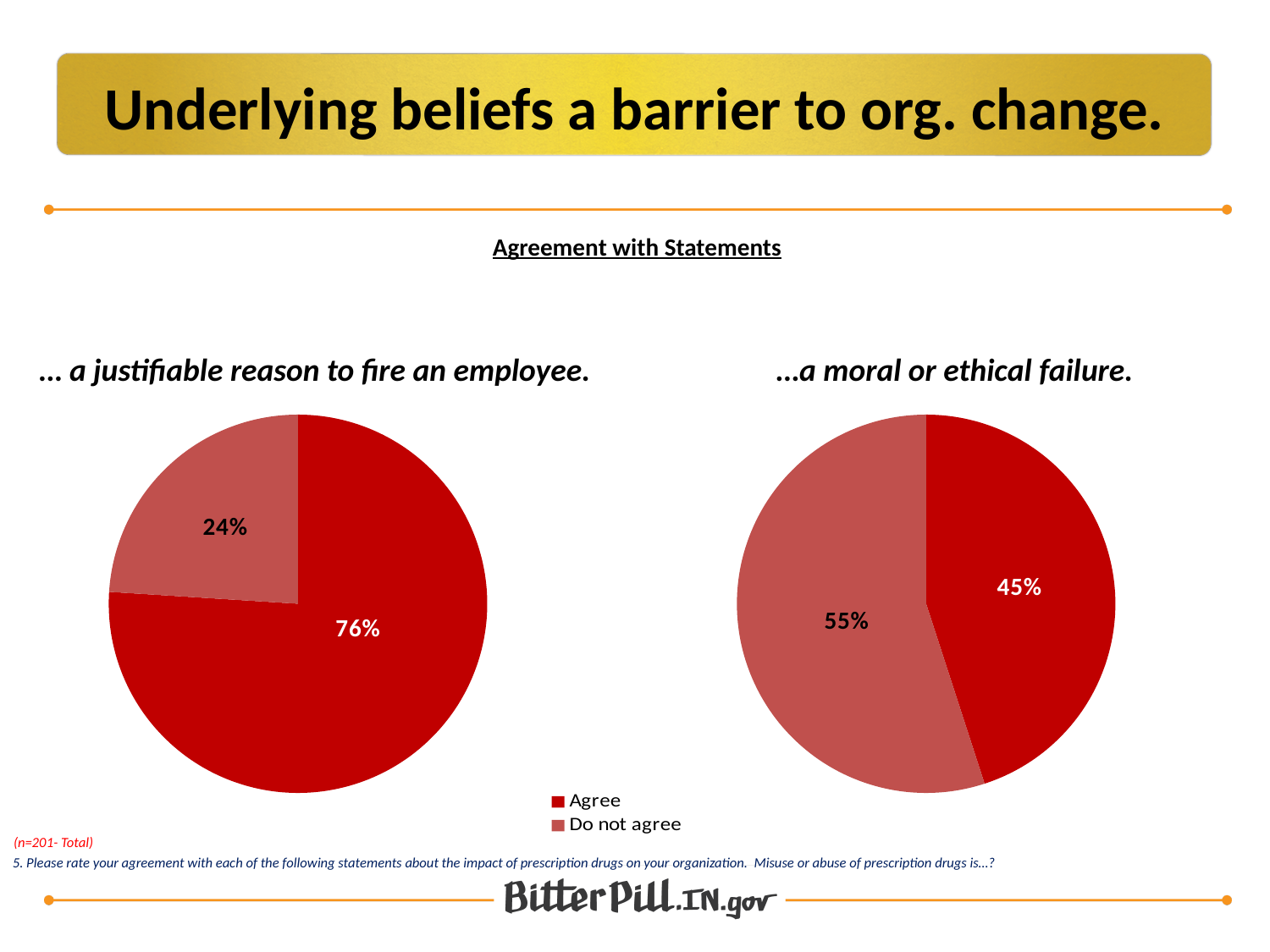
How many slices does the pie chart titled '...a moral or ethical failure.' have? 2 In the pie chart titled '...a moral or ethical failure.', what percentage of respondents do not agree? 55% In the pie chart titled '...a moral or ethical failure.', what percentage of respondents agree? 45% In the pie chart titled '... a justifiable reason to fire an employee.', what is the difference between the Agree and Do not agree slices? 52 percentage points What type of chart is used on this slide? Pie chart Which colour represents 'Do not agree' in the legend? Light red In the pie chart titled '... a justifiable reason to fire an employee.', what percentage of respondents do not agree? 24% In the pie chart titled '... a justifiable reason to fire an employee.', what percentage of respondents agree? 76% How many series does the legend list? 2 What is the difference between the Agree share in the '... a justifiable reason to fire an employee.' chart and the Agree share in the '...a moral or ethical failure.' chart? 31 percentage points In the pie chart titled '... a justifiable reason to fire an employee.', which slice is larger, Agree or Do not agree? Agree In the pie chart titled '...a moral or ethical failure.', which slice is larger, Agree or Do not agree? Do not agree